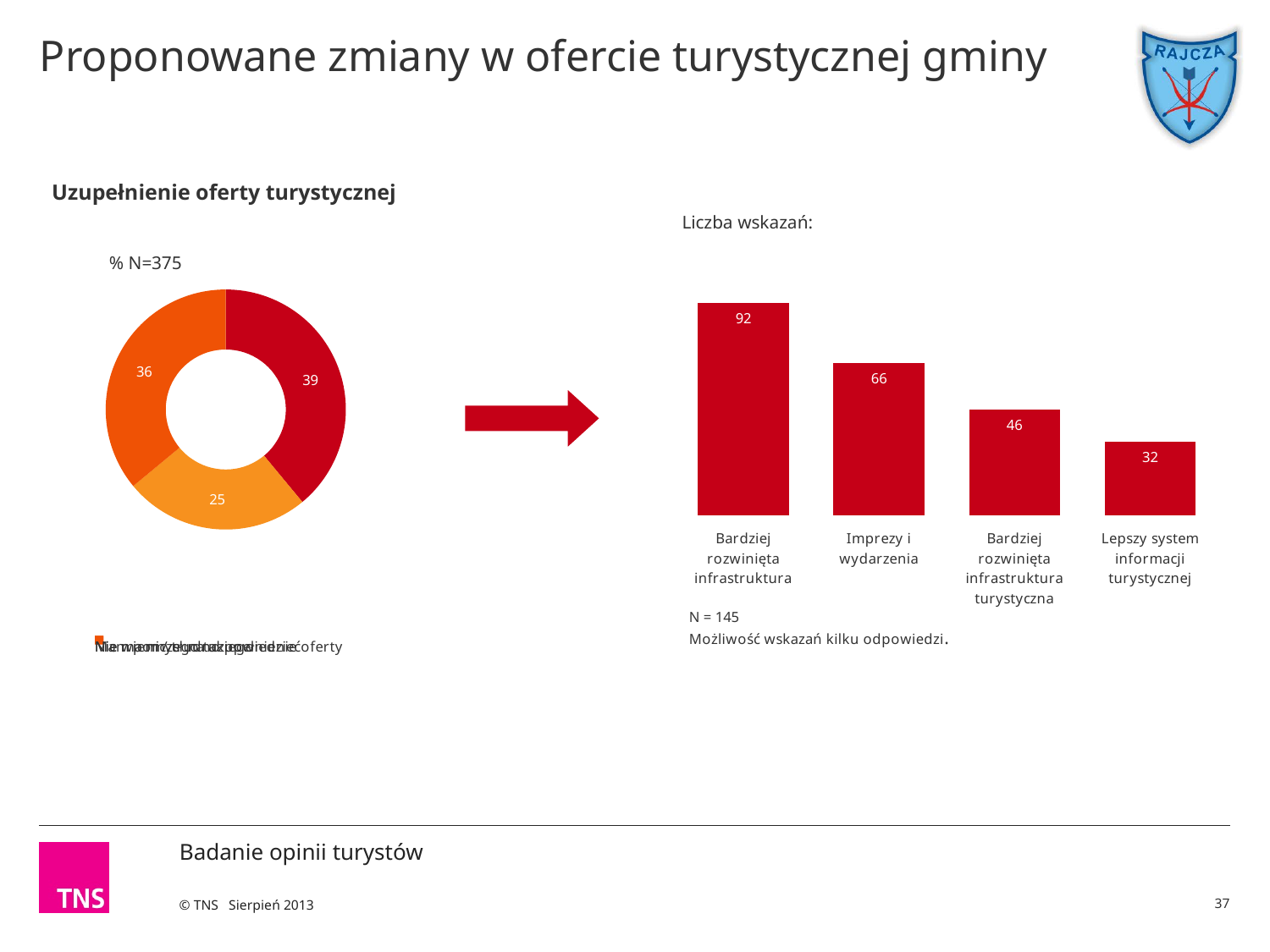
In the bar chart on the right, what is the difference between the values for "Bardziej rozwinięta infrastruktura" and "Imprezy i wydarzenia"? 26 In the bar chart on the right, what is the value for "Bardziej rozwinięta infrastruktura turystyczna"? 46 What kind of chart is the chart on the left of the slide? donut (pie) chart In the bar chart on the right, what is the value for "Lepszy system informacji turystycznej"? 32 Do the values in the bar chart on the right rise or fall from left to right? fall In the donut chart on the left, what is the value of the largest slice? 39 How many categories are shown in the bar chart on the right? 4 How many slices does the donut chart on the left have? 3 In the bar chart on the right, what is the value for "Imprezy i wydarzenia"? 66 In the bar chart on the right, which category has the highest value? Bardziej rozwinięta infrastruktura In the bar chart on the right, which category has the lowest value? Lepszy system informacji turystycznej In the bar chart on the right, which is larger: the value for "Imprezy i wydarzenia" or the value for "Bardziej rozwinięta infrastruktura turystyczna"? Imprezy i wydarzenia